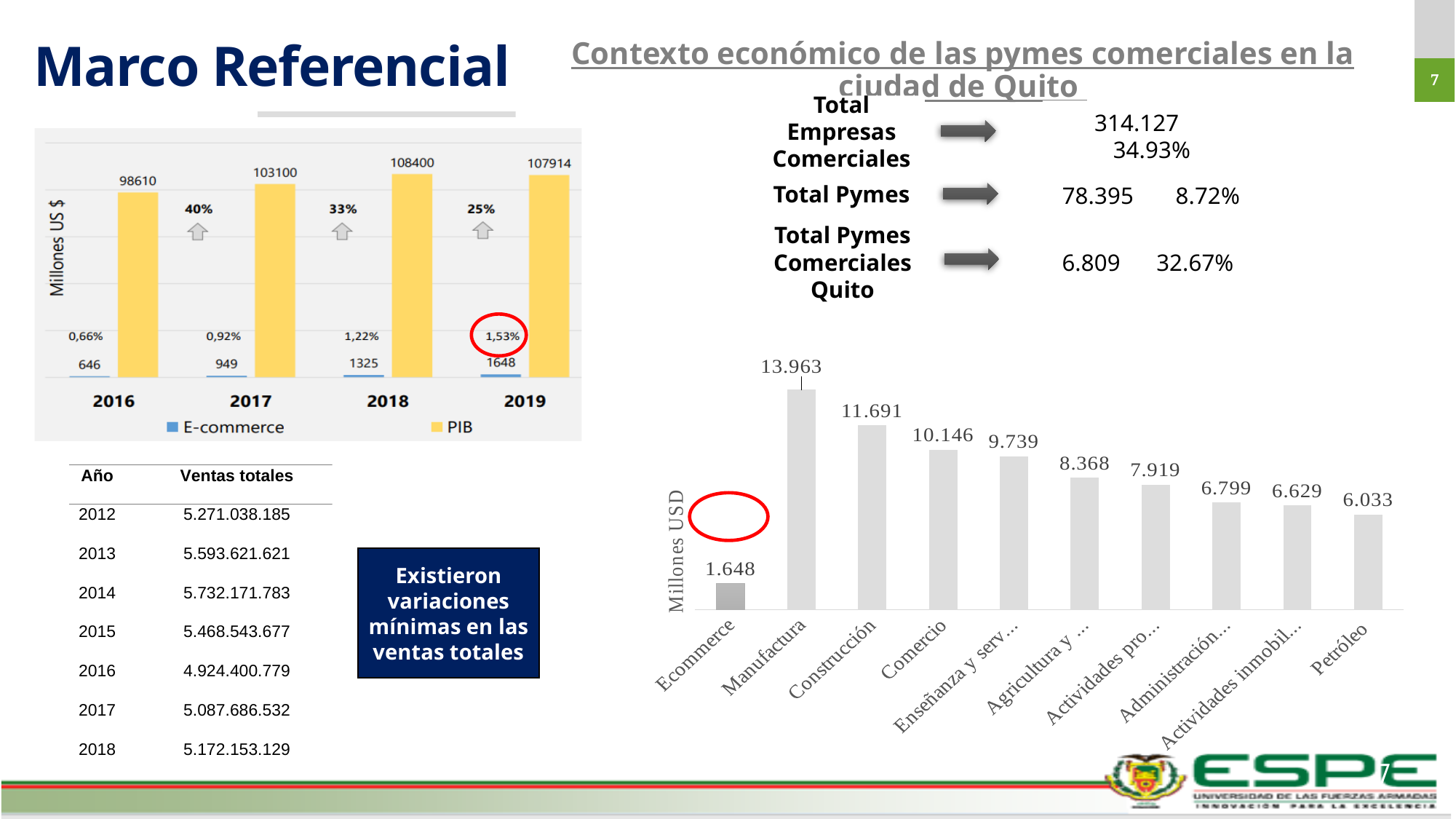
In the bar chart on the right of the slide, which is larger, the value for Comercio or the value for Petróleo? Comercio In the bar chart on the right of the slide, which category has the lowest value? Ecommerce In the chart on the left of the slide, what is the difference between the E-commerce values for 2019 and 2016? 1002 In the bar chart on the right of the slide, which category has the highest value? Manufactura In the chart on the left of the slide, do the E-commerce values rise or fall from 2016 to 2019? Rise In the chart on the left of the slide, what is the E-commerce value for 2019? 1648 What kind of chart is the chart on the right of the slide? Bar chart In the bar chart on the right of the slide, what is the value for Manufactura? 13.963 How many series does the legend of the chart on the left of the slide list? 2 In the bar chart on the right of the slide, what is the difference between the values for Manufactura and Construcción? 2.272 In the chart on the left of the slide, what is the PIB value for 2018? 108400 How many categories are shown in the bar chart on the right of the slide? 10